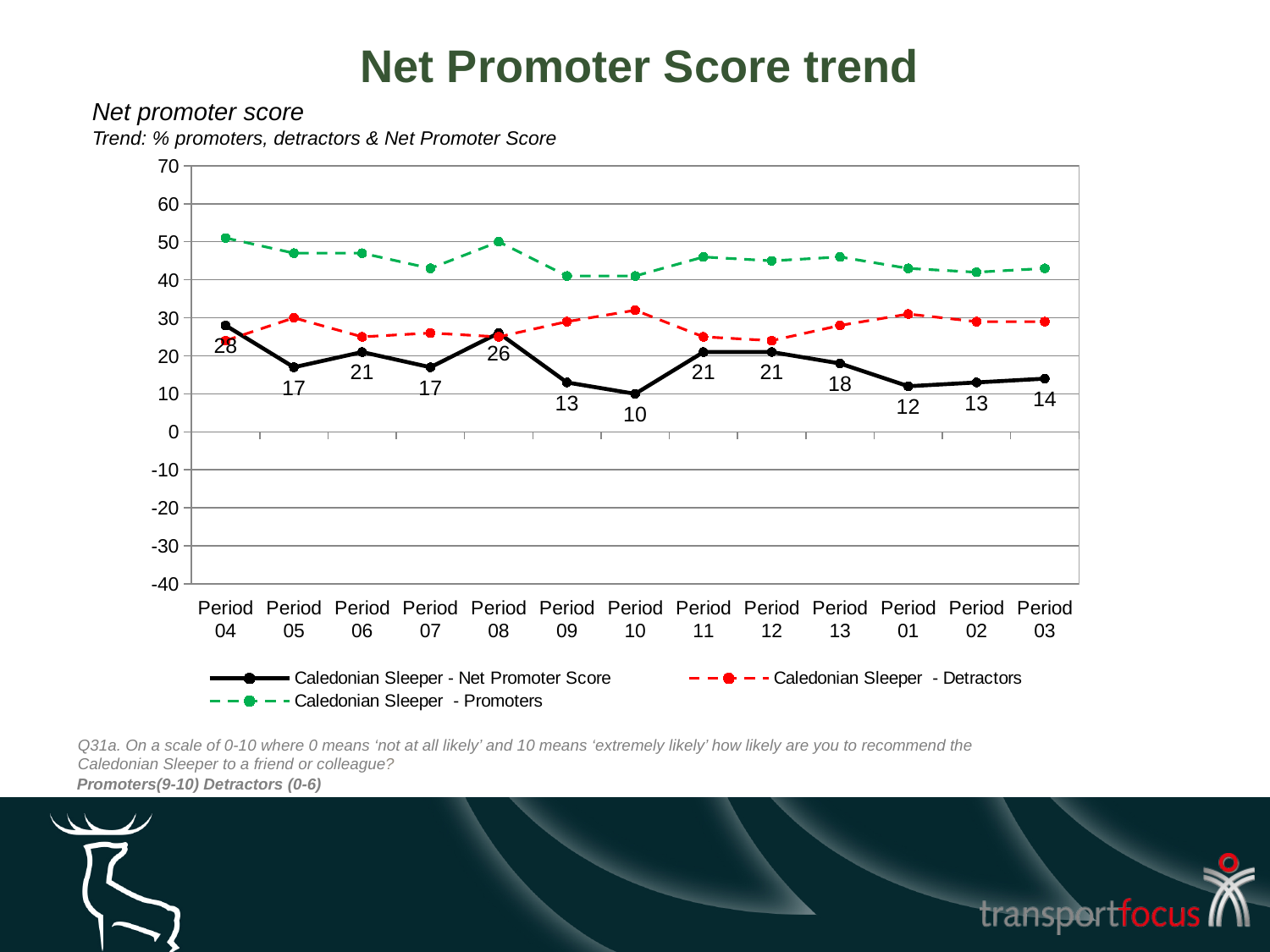
How many periods are shown on the x axis? 13 Which is larger, the Net Promoter Score for Period 13 or for Period 01? Period 13 What is the Net Promoter Score for Period 08? 26 Is the Promoters value for Period 04 greater or less than 40? greater Is the Detractors value for Period 04 greater or less than 30? less Which period has the highest Net Promoter Score? Period 04 How many series does the legend list? 3 Which period has the lowest Net Promoter Score? Period 10 What is the Net Promoter Score for Period 10? 10 What is the Net Promoter Score for Period 04? 28 What is the difference between the Net Promoter Score in Period 04 and Period 10? 18 What kind of chart is shown on the slide? Line chart